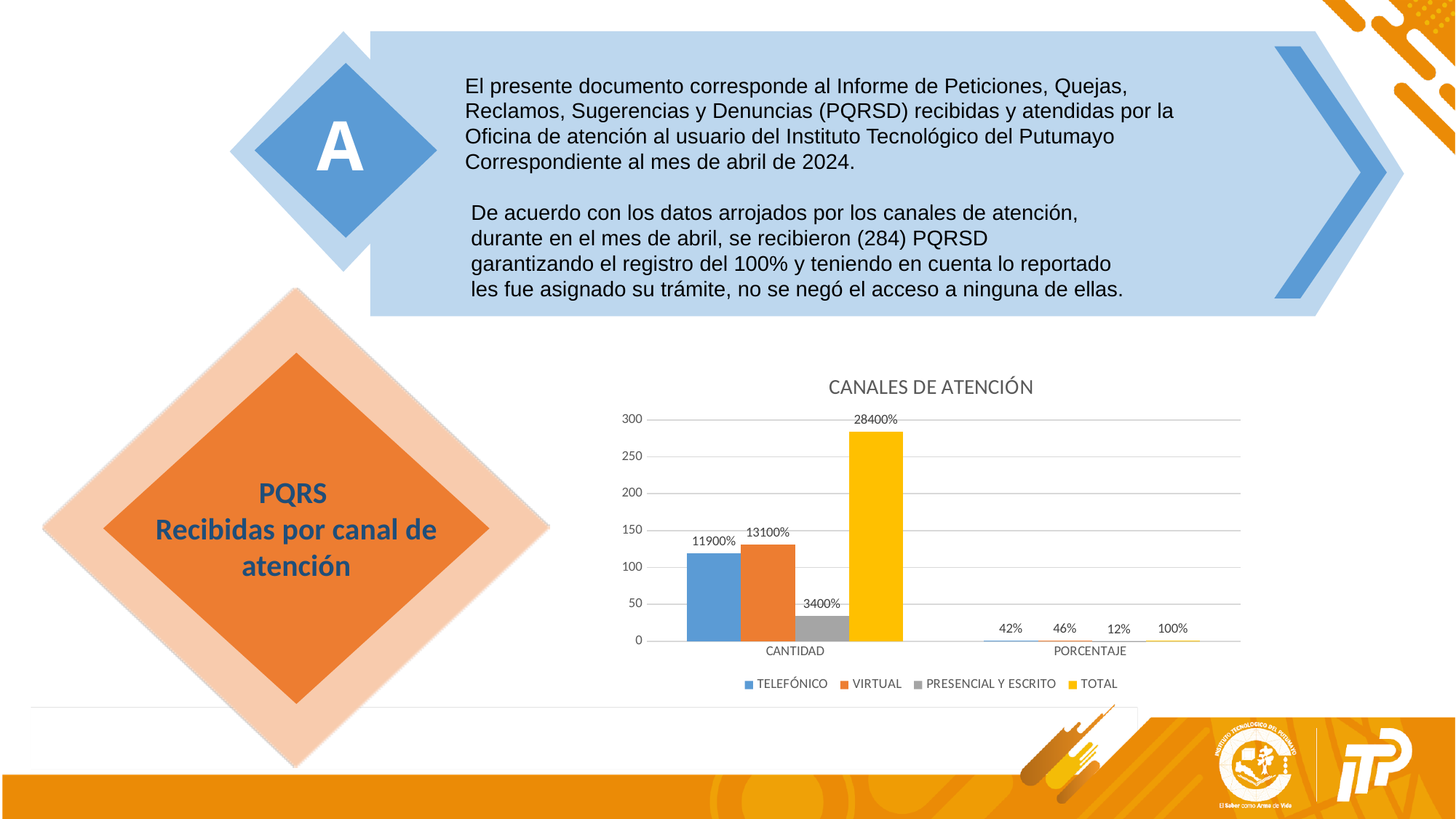
What kind of chart is shown under the title CANALES DE ATENCIÓN? bar chart What is the data label for PRESENCIAL Y ESCRITO in the CANTIDAD category? 3400% How many series does the legend of the CANALES DE ATENCIÓN chart list? 4 What is the data label for VIRTUAL in the PORCENTAJE category? 46% Which series has the smallest value in the PORCENTAJE category? PRESENCIAL Y ESCRITO What is the data label for TELEFÓNICO in the CANTIDAD category? 11900% What is the difference between the VIRTUAL and TELEFÓNICO labels in the PORCENTAJE category? 4% What is the data label for TOTAL in the PORCENTAJE category? 100% Which series has the tallest bar in the CANTIDAD category? TOTAL How many categories are shown on the x axis of the CANALES DE ATENCIÓN chart? 2 In the CANTIDAD category, which is larger: TELEFÓNICO or VIRTUAL? VIRTUAL What is the title of the chart on the slide? CANALES DE ATENCIÓN